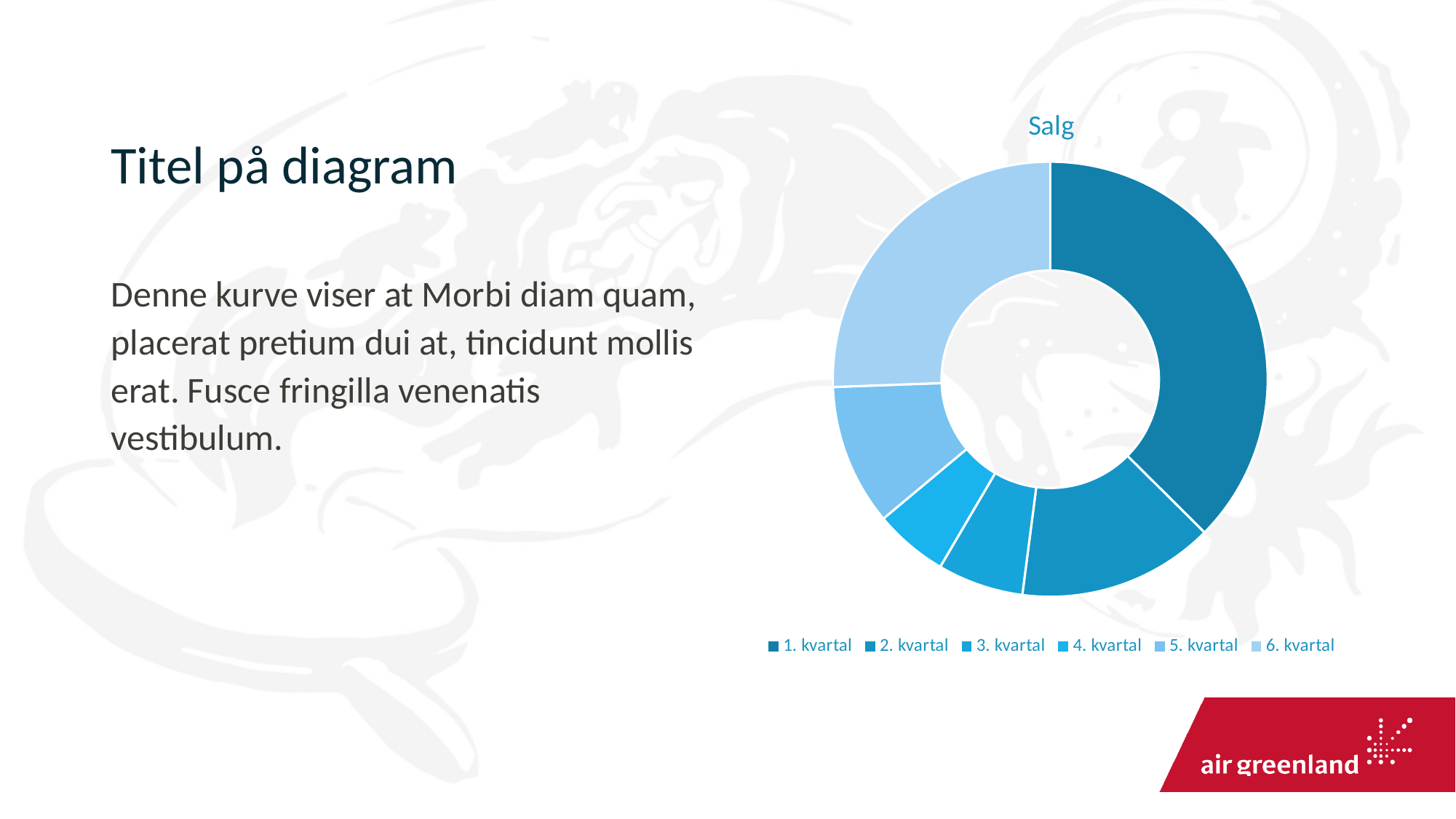
Which slice is larger, 5. kvartal or 6. kvartal? 6. kvartal How many categories does the chart show? 6 Which slice is larger, 2. kvartal or 5. kvartal? 2. kvartal Which category has the largest slice in the chart? 1. kvartal How many entries does the chart legend list? 6 What is the title of the chart? Salg What kind of chart is shown on the slide? Doughnut (pie) chart Which slice is larger, 1. kvartal or 2. kvartal? 1. kvartal What is the label of the first entry in the chart legend? 1. kvartal